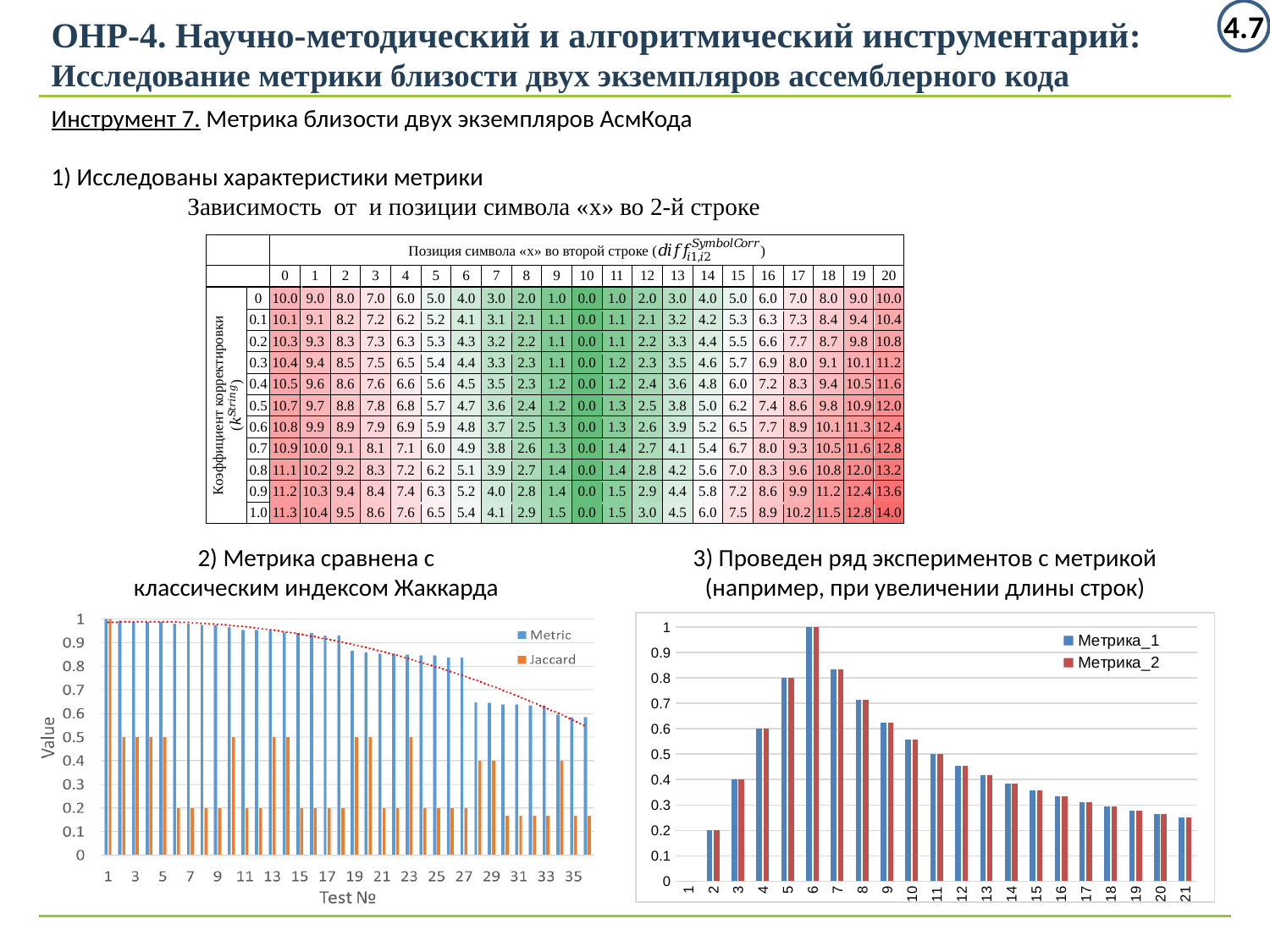
What kind of chart is the chart on the bottom left (Metric vs Jaccard)? bar chart What are the two series named in the legend of the bottom-left chart? Metric and Jaccard In the bottom-left chart, which series has the larger value at test 7, Metric or Jaccard? Metric In the bottom-right chart, which category has the highest value? 6 In the bottom-right chart, do the values rise or fall from category 6 to category 21? fall In the bottom-left chart, is the Jaccard value for test 7 greater or less than 0.3? less In the bottom-right chart, is the value of Метрика_1 for category 21 greater or less than 0.3? less In the bottom-right chart, is the value of Метрика_2 for category 8 greater or less than 0.6? greater How many series does the legend of the bottom-right chart list? 2 In the bottom-right chart, is the value for category 6 larger than the value for category 21? Yes What is the x-axis title of the bottom-left chart? Test №